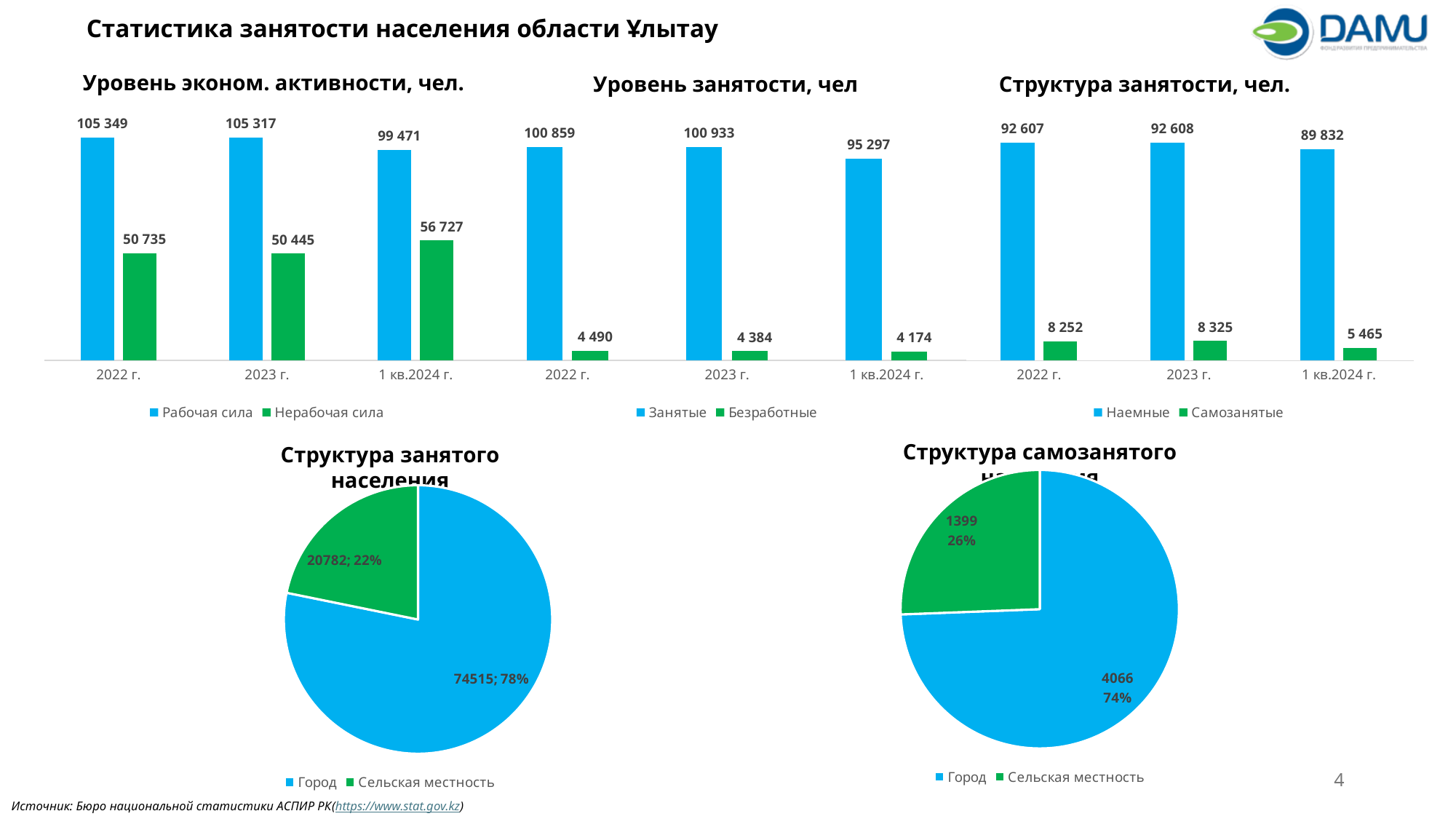
In the chart 'Структура занятости, чел.', how many series does the legend list? 2 In the chart 'Уровень занятости, чел', what is the difference between Занятые and Безработные for 1 кв.2024 г.? 91 123 In the chart 'Уровень эконом. активности, чел.', what is the value of Нерабочая сила for 1 кв.2024 г.? 56 727 In the chart 'Уровень эконом. активности, чел.', what is the value of Рабочая сила for 2022 г.? 105 349 In the pie chart 'Структура самозанятого населения', what is the value for Город? 4066 In the chart 'Уровень эконом. активности, чел.', does the value of Рабочая сила rise or fall from 2023 г. to 1 кв.2024 г.? fall In the chart 'Структура занятости, чел.', which period has the lowest value of Самозанятые? 1 кв.2024 г. In the chart 'Уровень занятости, чел', what is the value of Безработные for 2023 г.? 4 384 What type of chart is 'Структура самозанятого населения'? pie chart In the chart 'Уровень занятости, чел', which period has the highest value of Занятые? 2023 г. In the chart 'Структура занятости, чел.', what is the value of Наемные for 1 кв.2024 г.? 89 832 In the pie chart 'Структура занятого населения', what share does Сельская местность have? 22%